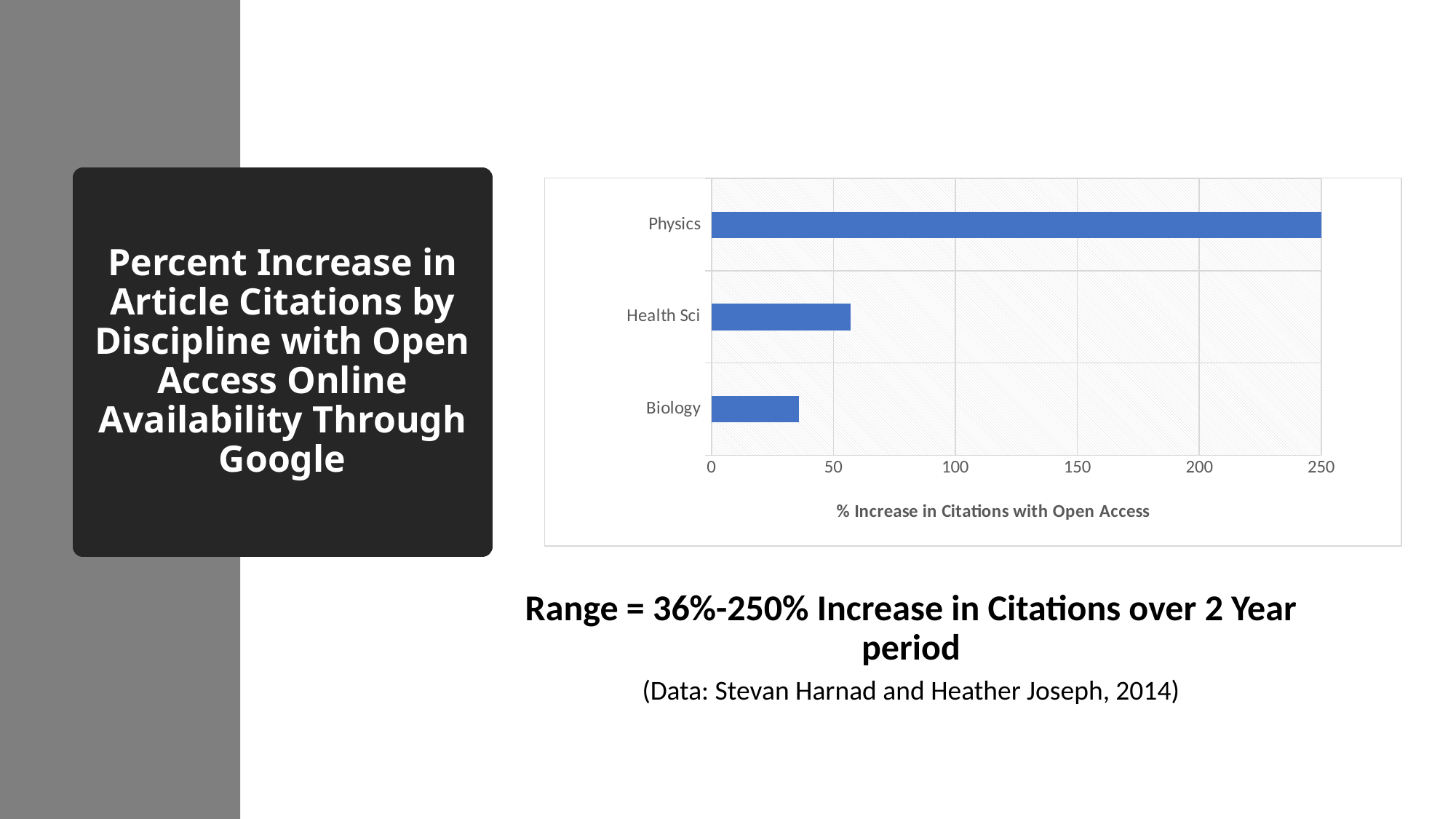
What kind of chart is shown on the slide? bar chart Which discipline has the highest percent increase in citations? Physics Which has a larger percent increase in citations, Physics or Health Sci? Physics Which discipline has the lowest percent increase in citations? Biology Is the value for Biology greater or less than 50? less What is the label on the horizontal axis of the chart? % Increase in Citations with Open Access What is the highest value shown on the horizontal axis of the chart? 250 Is the value for Physics greater or less than 200? greater How many disciplines are plotted in the chart? 3 Is the value for Health Sci greater or less than 50? greater Which has a larger percent increase in citations, Health Sci or Biology? Health Sci What is the percent increase in citations for Physics? 250